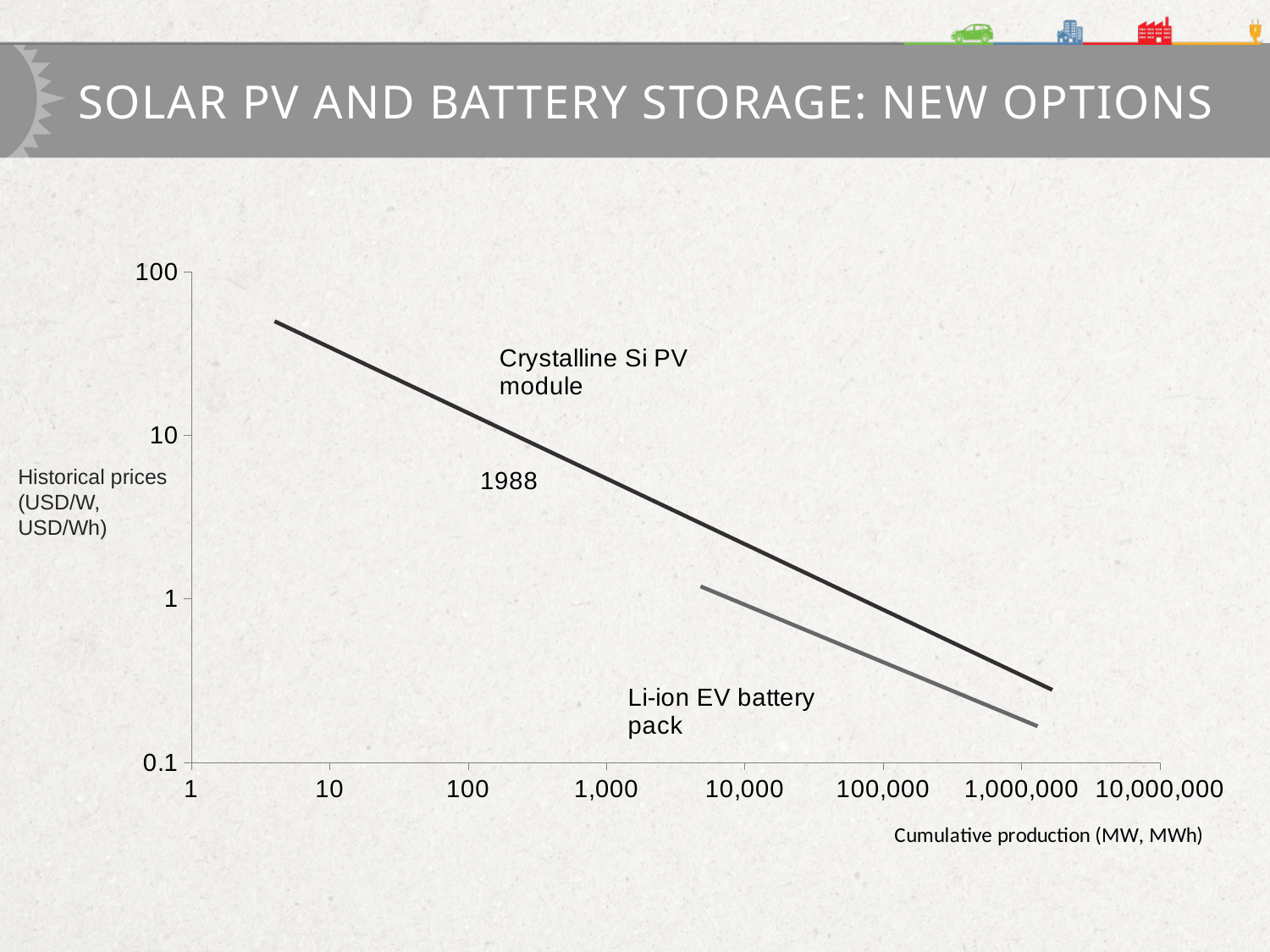
Is the Crystalline Si PV module price at a cumulative production of 10 greater or less than 10? greater How many lines (series) are plotted on the chart? 2 What is the title of the chart's x axis? Cumulative production (MW, MWh) Is the Crystalline Si PV module price at a cumulative production of 1,000 greater or less than 10? less Is the Crystalline Si PV module price at a cumulative production of 1,000 greater or less than 1? greater Does the Li-ion EV battery pack line rise or fall as cumulative production increases? fall What is the label on the chart's y axis? Historical prices (USD/W, USD/Wh) At a cumulative production of 100,000, which line shows the higher price: Crystalline Si PV module or Li-ion EV battery pack? Crystalline Si PV module Do the prices rise or fall as cumulative production increases along the x axis? fall Which year is annotated on the Crystalline Si PV module line? 1988 What kind of chart is shown on the slide? line chart